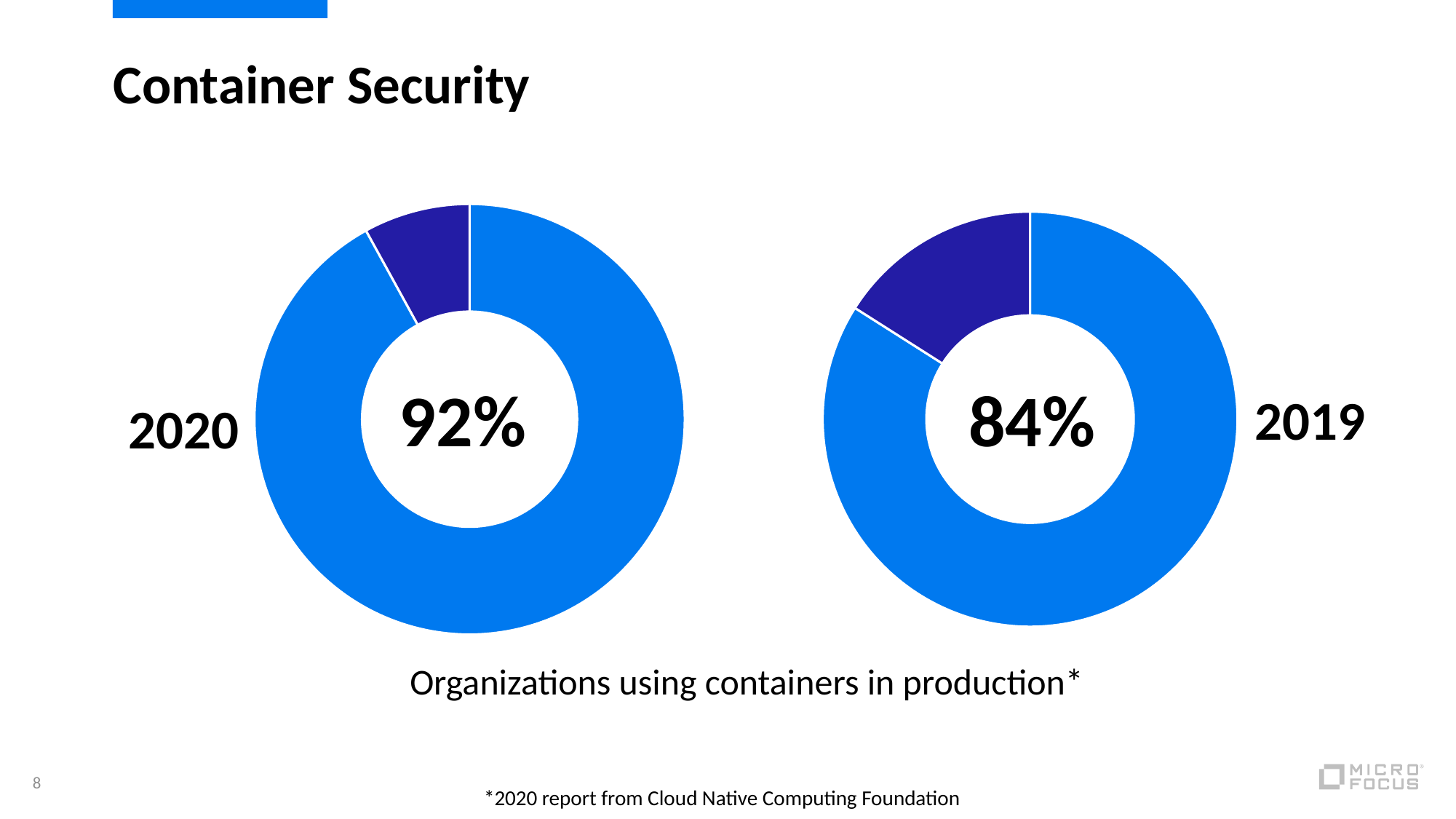
How many donut charts are shown on the slide? 2 By how many percentage points did the share of organizations using containers in production change from 2019 to 2020? 8 percentage points What kind of chart is used to show the 2020 and 2019 values? Donut (pie) chart Is the value shown for 2019 greater or less than 90%? less In the 2020 donut chart, what share of the ring is taken by the dark blue slice? 8% What percentage is shown in the centre of the 2019 donut chart? 84% What is the title of the slide containing the two donut charts? Container Security In the 2019 donut chart, what share of the ring is taken by the dark blue slice? 16% Which year shows the higher percentage of organizations using containers in production, 2019 or 2020? 2020 Did the percentage of organizations using containers in production rise or fall from 2019 to 2020? Rise What percentage is shown in the centre of the 2020 donut chart? 92% What do the two donut charts measure, according to the caption beneath them? Organizations using containers in production